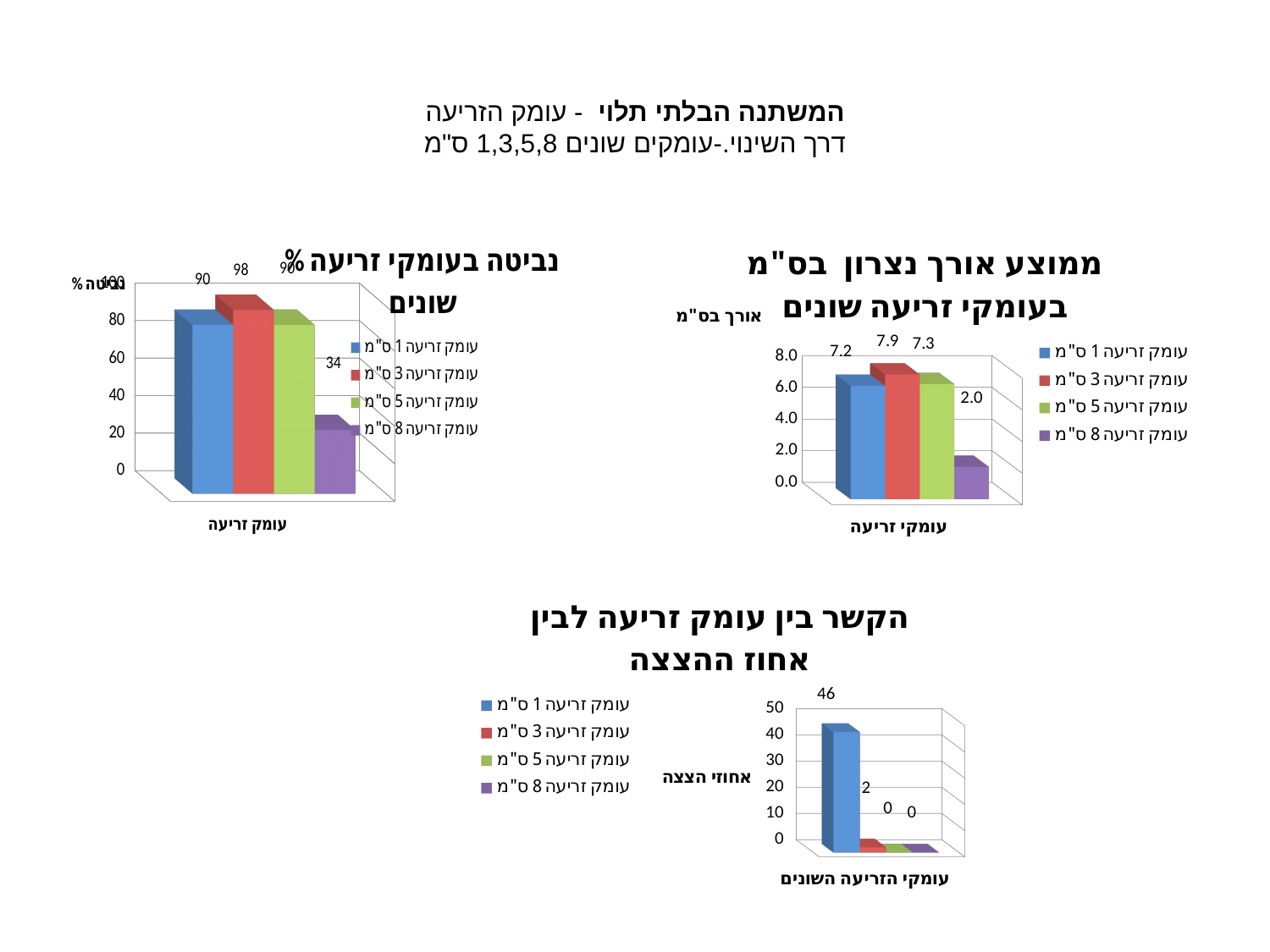
In the top-left chart (נביטה בעומקי זריעה שונים %), what is the value for עומק זריעה 8 ס"מ? 34 How many series does the legend of the bottom chart (הקשר בין עומק זריעה לבין אחוז ההצצה) list? 4 In the bottom chart (הקשר בין עומק זריעה לבין אחוז ההצצה), what is the difference between the values for עומק זריעה 1 ס"מ and עומק זריעה 3 ס"מ? 44 In the bottom chart (הקשר בין עומק זריעה לבין אחוז ההצצה), what is the value for עומק זריעה 1 ס"מ? 46 In the top-right chart (ממוצע אורך נצרון בס"מ בעומקי זריעה שונים), which sowing depth has the lowest value? עומק זריעה 8 ס"מ In the top-right chart (ממוצע אורך נצרון בס"מ בעומקי זריעה שונים), what is the value for עומק זריעה 3 ס"מ? 7.9 In the top-left chart (נביטה בעומקי זריעה שונים %), is the value for עומק זריעה 8 ס"מ greater or less than 40? less In the top-right chart (ממוצע אורך נצרון בס"מ בעומקי זריעה שונים), what is the value for עומק זריעה 8 ס"מ? 2.0 In the top-right chart (ממוצע אורך נצרון בס"מ בעומקי זריעה שונים), what is the difference between the values for עומק זריעה 3 ס"מ and עומק זריעה 1 ס"מ? 0.7 In the top-left chart (נביטה בעומקי זריעה שונים %), what is the value for עומק זריעה 3 ס"מ? 98 In the top-left chart (נביטה בעומקי זריעה שונים %), which sowing depth has the highest value? עומק זריעה 3 ס"מ What kind of chart is the top-right chart (ממוצע אורך נצרון בס"מ בעומקי זריעה שונים)? bar chart